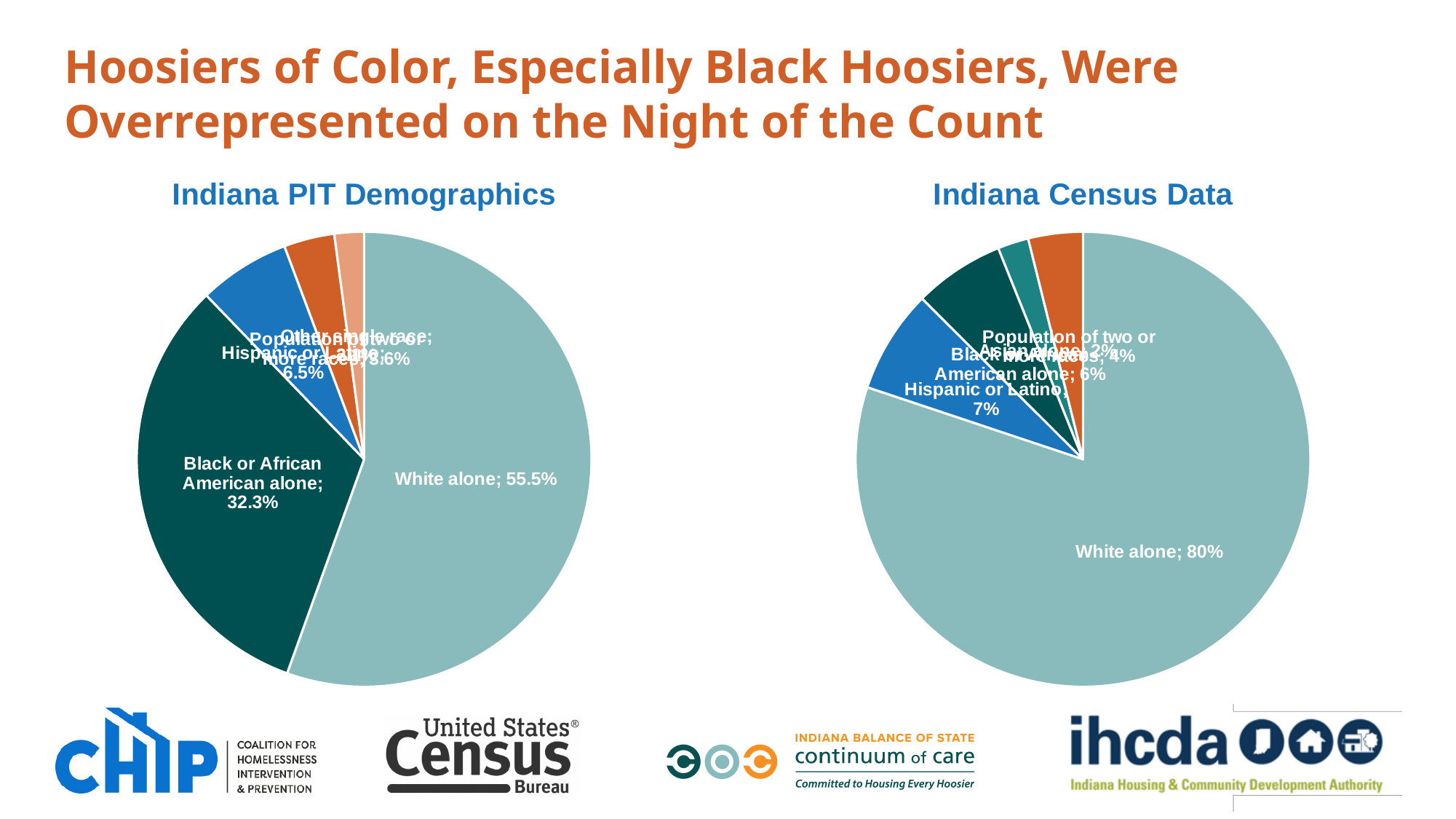
In the Indiana PIT Demographics chart, what percentage is White alone? 55.5% In the Indiana PIT Demographics chart, which category has the largest share? White alone In the Indiana PIT Demographics chart, what percentage is Black or African American alone? 32.3% What is the difference between the White alone share in the Indiana Census Data chart and the White alone share in the Indiana PIT Demographics chart? 24.5% In the Indiana PIT Demographics chart, what percentage is Hispanic or Latino? 6.5% In the Indiana Census Data chart, what percentage is Black or African American alone? 6% In the Indiana Census Data chart, which category has the smallest share? Asian alone How many slices does the Indiana Census Data pie chart have? 5 In the Indiana Census Data chart, what percentage is White alone? 80% What type of chart is used for Indiana PIT Demographics? Pie chart In the Indiana Census Data chart, what percentage is Asian alone? 2% Is the Black or African American alone share larger in the Indiana PIT Demographics chart or in the Indiana Census Data chart? Indiana PIT Demographics